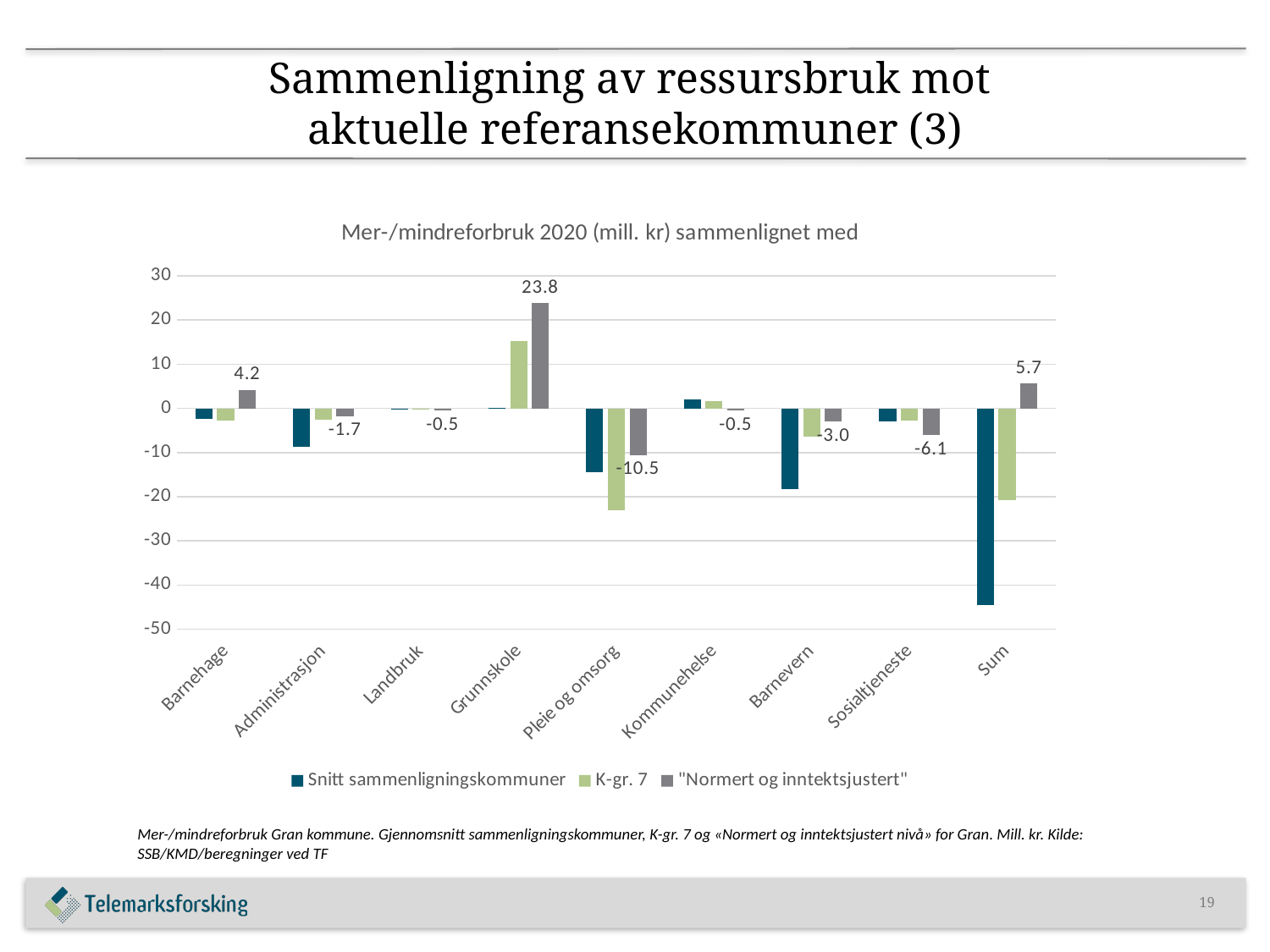
Which category has the lowest value in the "Normert og inntektsjustert" series? Pleie og omsorg How many series does the legend list? 3 Is the value for Grunnskole in the K-gr. 7 series greater or less than 10? greater In the "Normert og inntektsjustert" series, is the value for Barnehage or Sum larger? Sum What is the value for Grunnskole in the "Normert og inntektsjustert" series? 23.8 What is the value for Sosialtjeneste in the "Normert og inntektsjustert" series? -6.1 What is the value for Sum in the "Normert og inntektsjustert" series? 5.7 How many categories are shown on the x axis? 9 What is the difference between the "Normert og inntektsjustert" values for Grunnskole and Barnehage? 19.6 What is the value for Pleie og omsorg in the "Normert og inntektsjustert" series? -10.5 Is the value for Sum in the Snitt sammenligningskommuner series greater or less than -40? less Which category has the highest value in the "Normert og inntektsjustert" series? Grunnskole